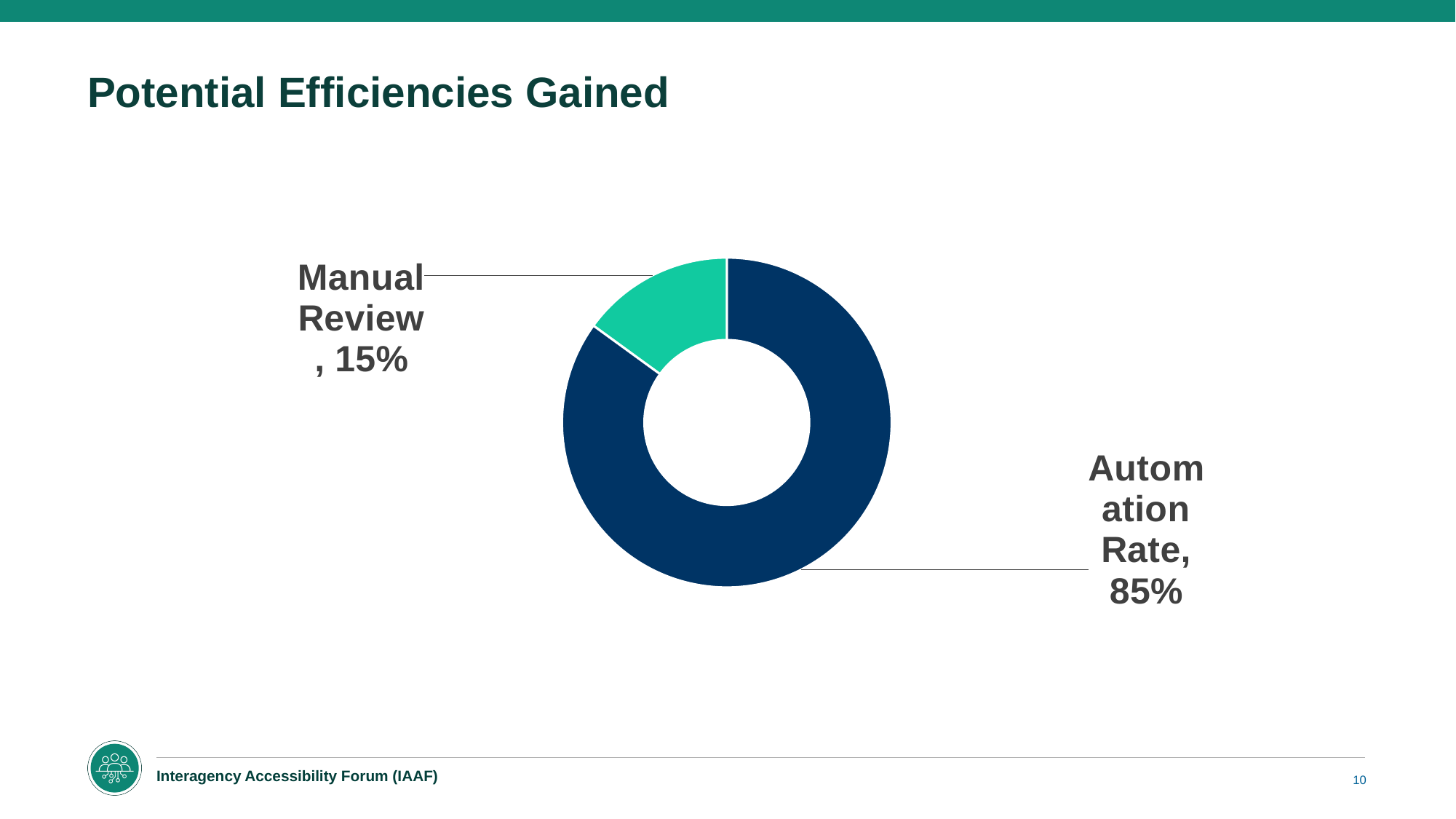
What percentage is shown for Automation Rate? 85% What is the title of the slide containing the chart? Potential Efficiencies Gained What share of the chart does Manual Review represent? 15% What percentage is shown for Manual Review? 15% Which slice of the chart is the largest? Automation Rate How many slices does the chart have? 2 What kind of chart is shown on the slide? Doughnut (pie) chart Which is larger, Automation Rate or Manual Review? Automation Rate What is the difference in percentage points between Automation Rate and Manual Review? 70 What is the total of the two slices shown? 100% Which slice of the chart is the smallest? Manual Review What colour is the Manual Review slice? Green